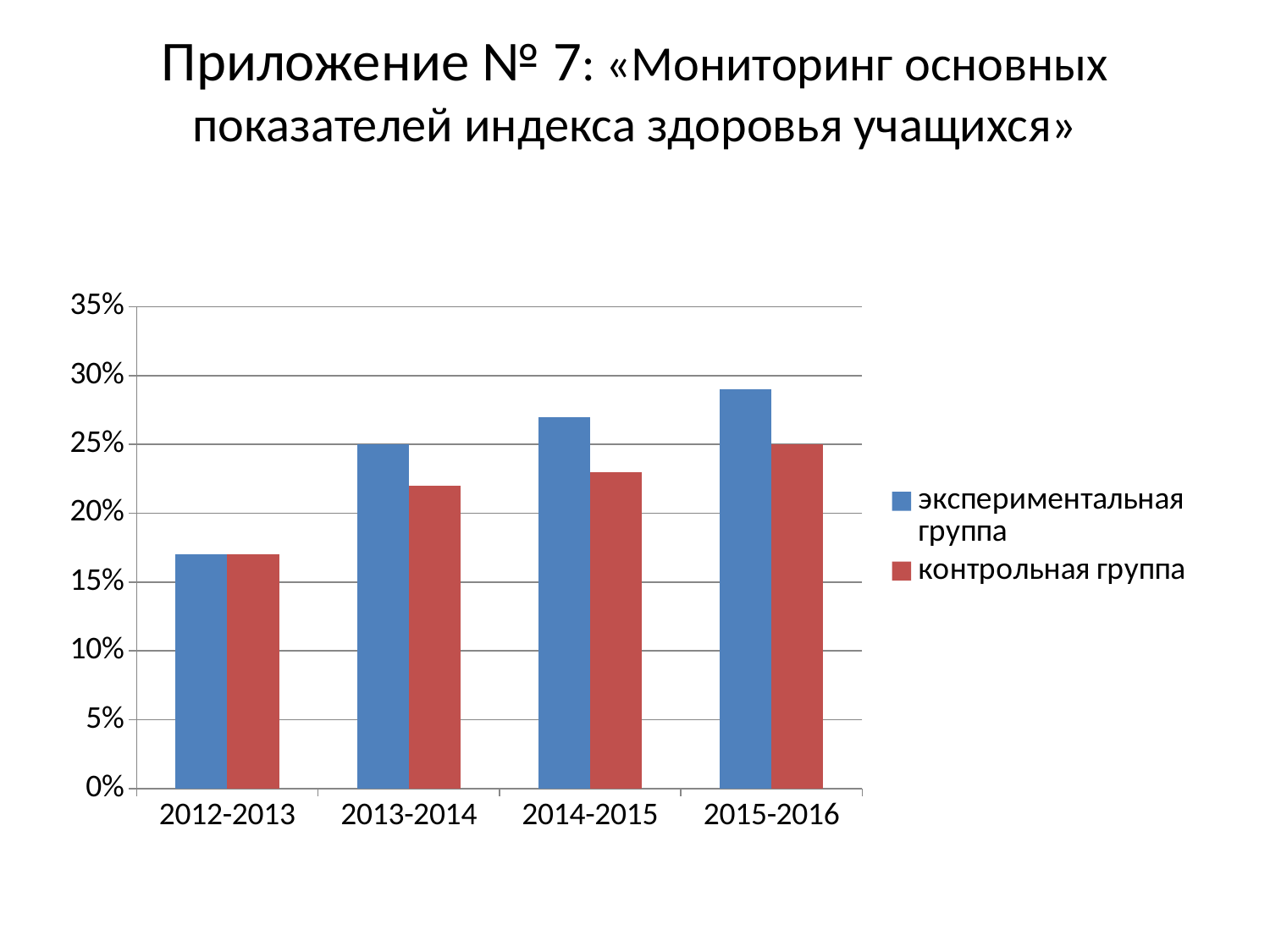
How many academic-year categories are shown on the x axis? 4 In 2014-2015, which group has the larger value, экспериментальная группа or контрольная группа? экспериментальная группа Do the values for экспериментальная группа rise or fall from 2012-2013 to 2015-2016? rise How many series does the legend list? 2 Is the value for контрольная группа in 2012-2013 greater or less than 20%? less What colour are the bars for экспериментальная группа? blue Is the value for экспериментальная группа in 2015-2016 greater or less than 25%? greater What is the value for контрольная группа in 2015-2016? 25% What is the value for экспериментальная группа in 2013-2014? 25% What kind of chart is shown on the slide? bar chart In which year is the value for экспериментальная группа highest? 2015-2016 In which year is the value for контрольная группа lowest? 2012-2013